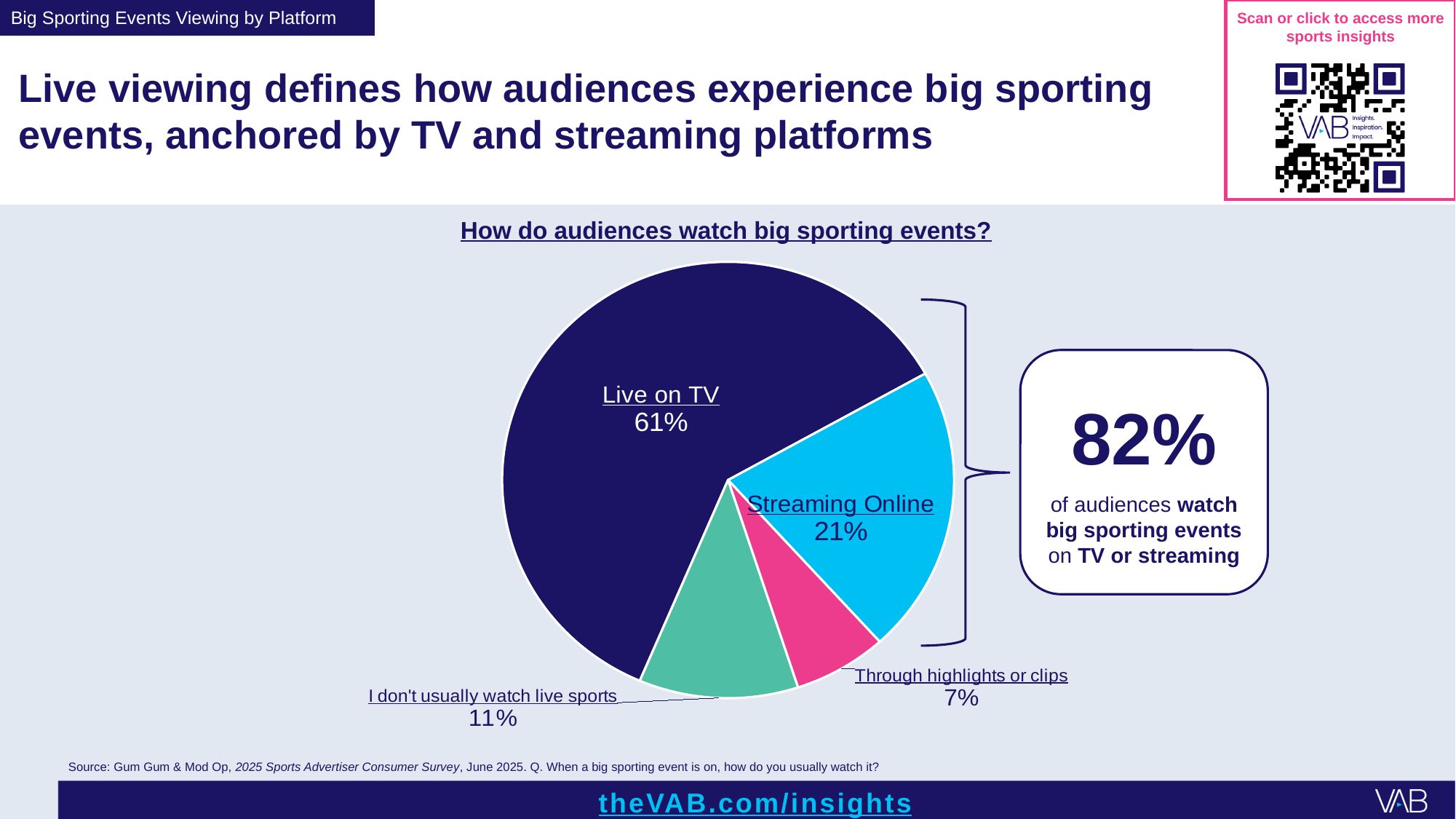
What kind of chart is shown on the slide? Pie chart What is the combined share of audiences who watch on TV or streaming, as shown in the callout? 82% What is the difference in percentage points between Live on TV and Streaming Online? 40 percentage points Which is larger: the share for Streaming Online or the share for I don't usually watch live sports? Streaming Online What is the title of the pie chart? How do audiences watch big sporting events? What percentage of audiences watch big sporting events by streaming online? 21% What percentage of audiences say they don't usually watch live sports? 11% Which category has the largest share of the pie? Live on TV What percentage of audiences watch big sporting events through highlights or clips? 7% How many slices does the pie chart have? 4 Which category has the smallest share of the pie? Through highlights or clips What percentage of audiences watch big sporting events live on TV? 61%